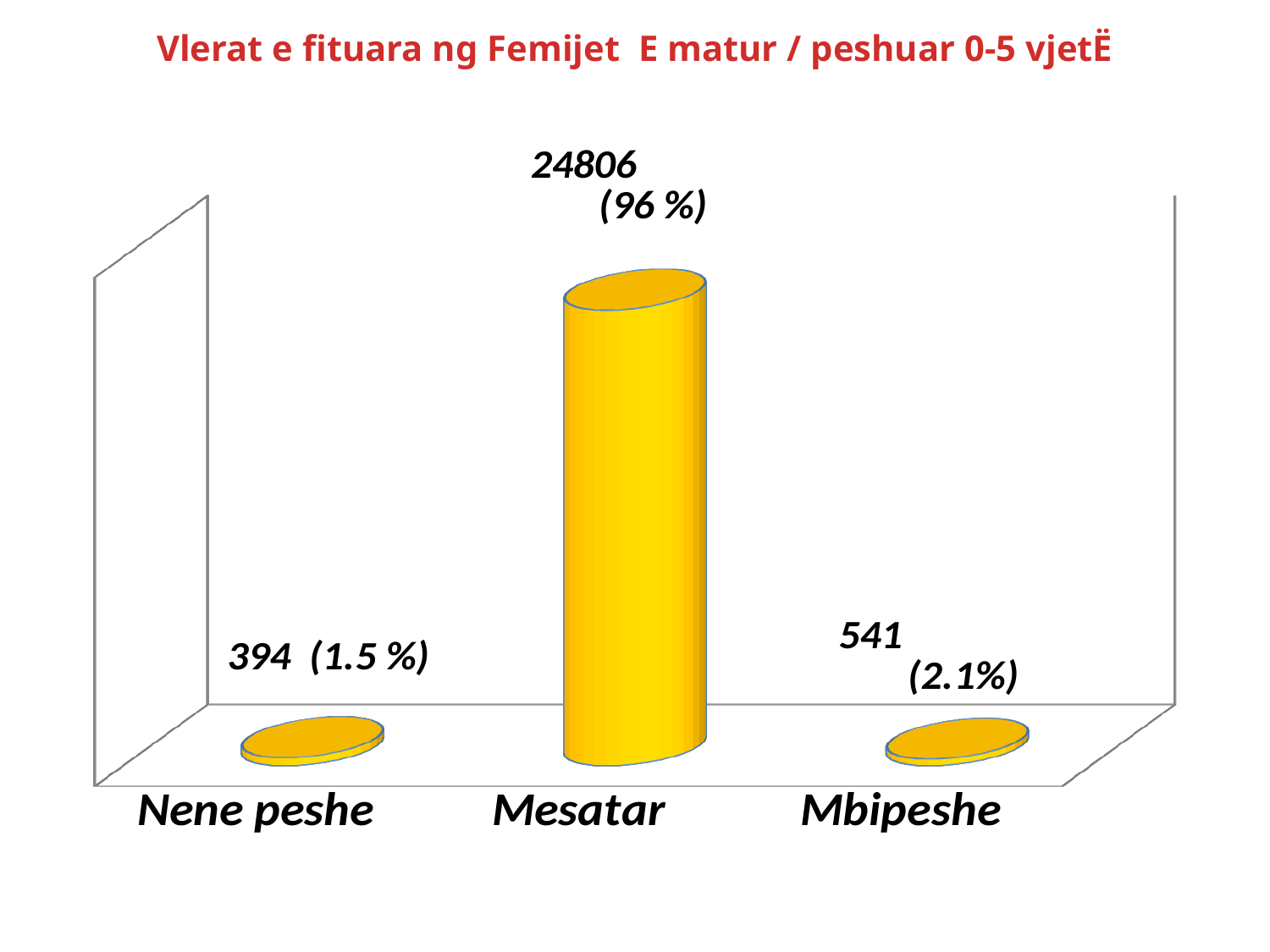
Which category has the highest value? Mesatar What value is shown for Mesatar? 24806 What is the difference between the values for Mbipeshe and Nene peshe? 147 Which category has the lowest value? Nene peshe What value is shown for Mbipeshe? 541 What percentage is shown next to the Mbipeshe bar? 2.1% What percentage is shown next to the Mesatar bar? 96 % What kind of chart is shown on the slide? Bar chart What value is shown for Nene peshe? 394 Which is larger, the value for Mbipeshe or the value for Nene peshe? Mbipeshe How many categories are shown on the chart? 3 What is the difference between the values for Mesatar and Mbipeshe? 24265